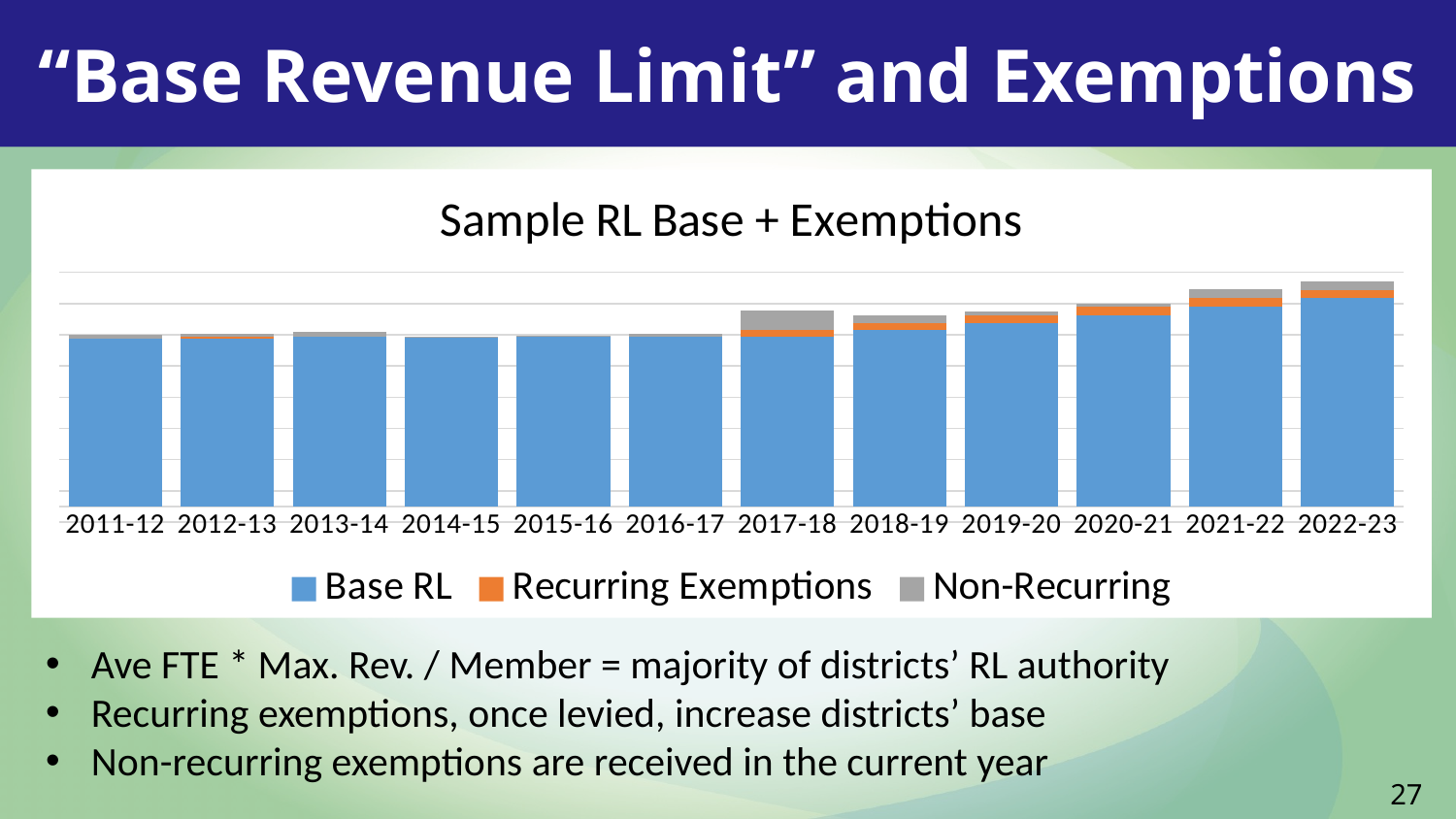
Which year has the largest Non-Recurring segment? 2017-18 Is the Base RL segment for 2021-22 larger or smaller than the Base RL segment for 2014-15? Larger Which year has the tallest total stacked bar? 2022-23 Which series is shown in orange in the legend? Recurring Exemptions How many series does the legend list? 3 Is the total bar for 2022-23 larger or smaller than the total bar for 2011-12? Larger Which series makes up the largest portion of every bar? Base RL What is the first school year shown on the x axis? 2011-12 How many school years are shown on the x axis? 12 What kind of chart is shown on the slide? Stacked bar chart What is the title of the chart? Sample RL Base + Exemptions Do the total bar heights generally rise or fall from 2016-17 to 2022-23? Rise